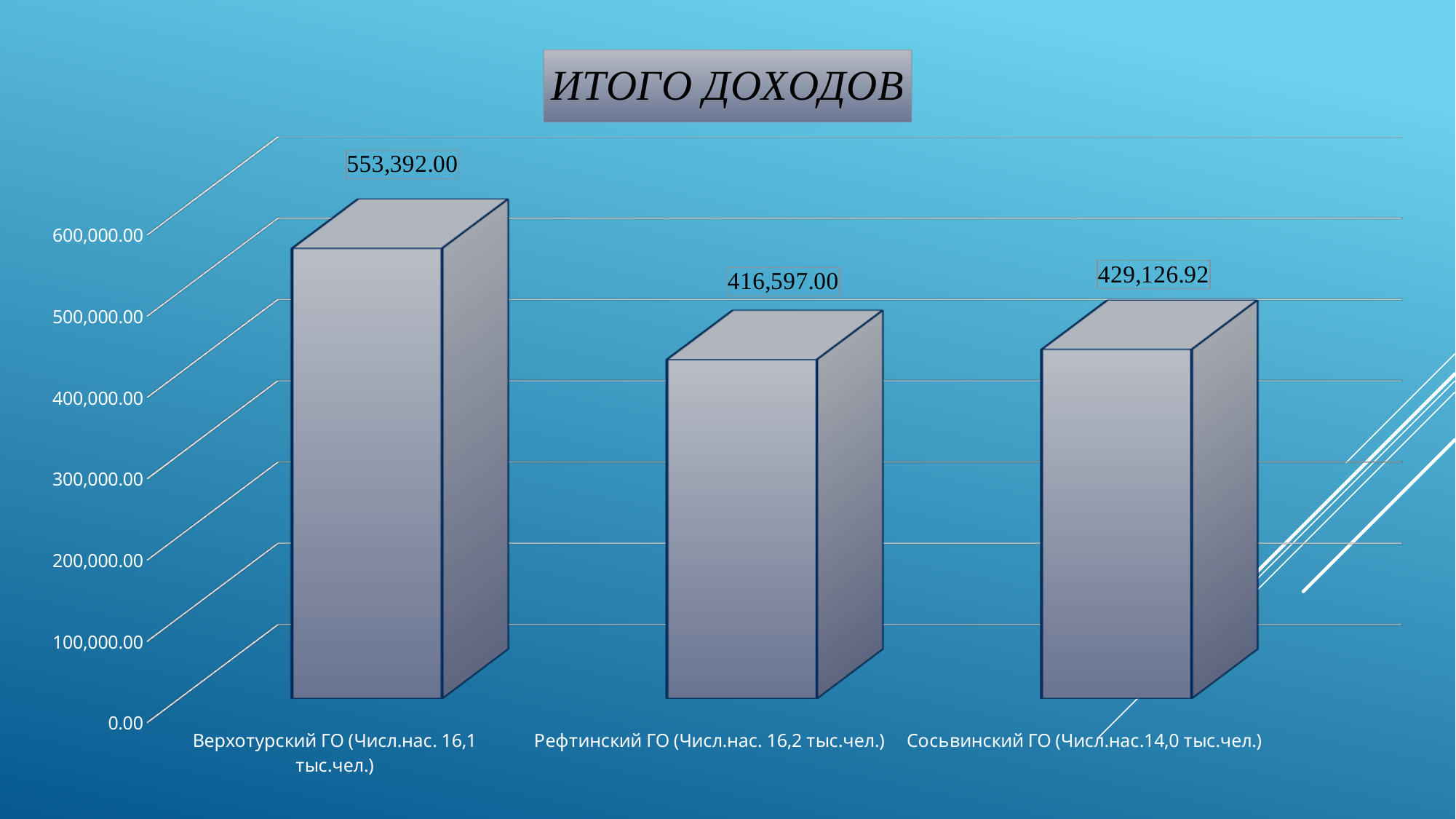
Which category has the lowest value? Рефтинский ГО What is the value for Верхотурский ГО? 553,392.00 What kind of chart is shown on the slide? bar chart Which category has the highest value? Верхотурский ГО Is the value for Рефтинский ГО greater or less than 500,000.00? less What is the difference between the values for Верхотурский ГО and Рефтинский ГО? 136,795.00 What is the value for Сосьвинский ГО? 429,126.92 What is the value for Рефтинский ГО? 416,597.00 Which is larger, the value for Верхотурский ГО or the value for Сосьвинский ГО? Верхотурский ГО How many categories are shown in the chart? 3 What is the difference between the values for Сосьвинский ГО and Рефтинский ГО? 12,529.92 What is the title of the chart? ИТОГО ДОХОДОВ